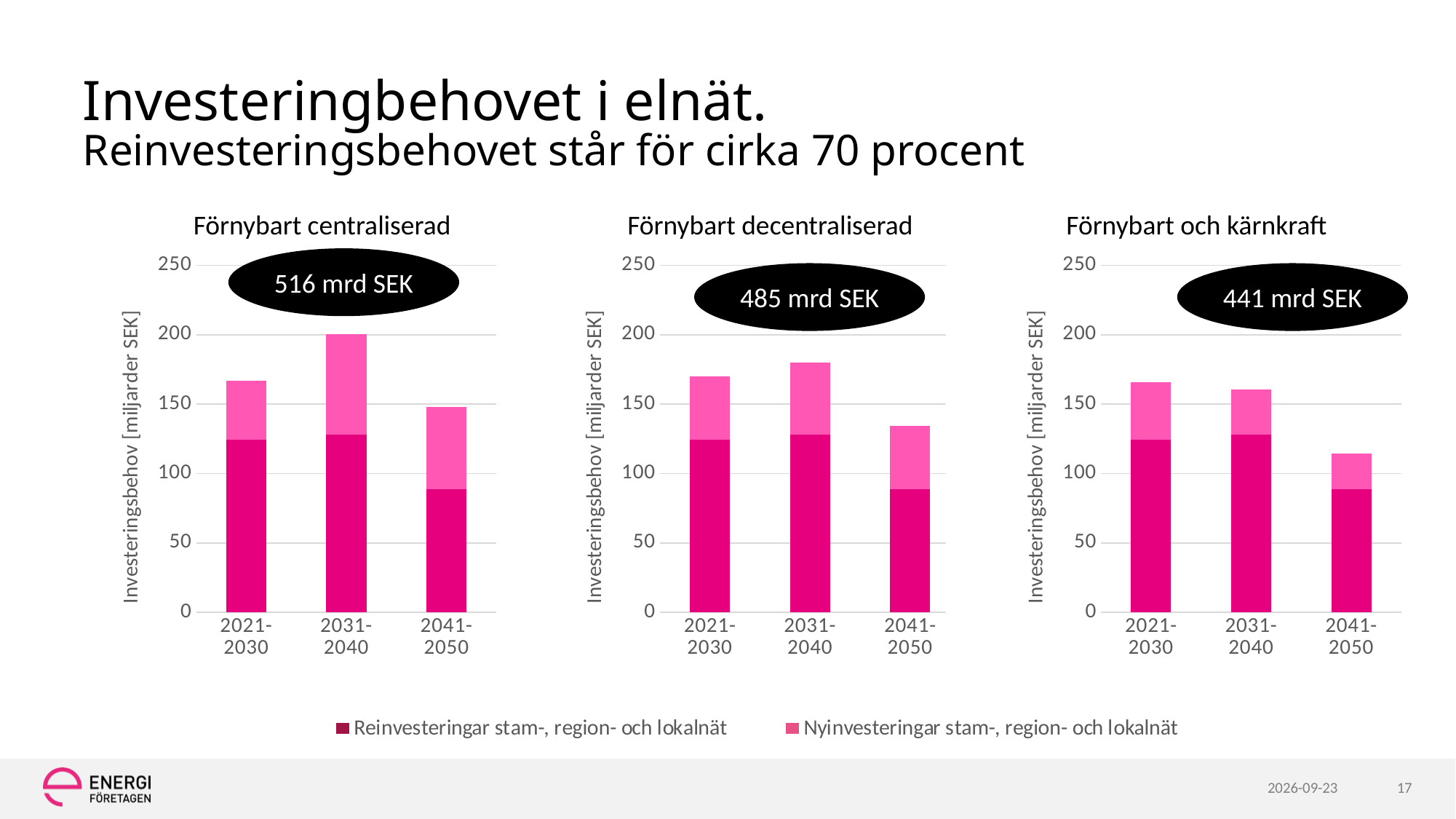
How many series does the legend list for the charts? 2 What is the label on the y axis of the charts? Investeringsbehov [miljarder SEK] In the "Förnybart centraliserad" chart, which period has the highest total bar? 2031-2040 In the "Förnybart decentraliserad" chart, is the total bar for 2021-2030 greater or less than 150? greater In the "Förnybart och kärnkraft" chart, is the total bar for 2041-2050 greater or less than 100? greater In the "Förnybart decentraliserad" chart, what total investment need is printed in the black oval? 485 mrd SEK In the "Förnybart centraliserad" chart, which total bar is larger: 2021-2030 or 2041-2050? 2021-2030 In the "Förnybart och kärnkraft" chart, which period has the lowest total bar? 2041-2050 In the "Förnybart centraliserad" chart, what total investment need is printed in the black oval? 516 mrd SEK How many time periods are shown on the x axis of the "Förnybart decentraliserad" chart? 3 What kind of chart is the "Förnybart centraliserad" chart? Stacked bar chart In the "Förnybart och kärnkraft" chart, what total investment need is printed in the black oval? 441 mrd SEK